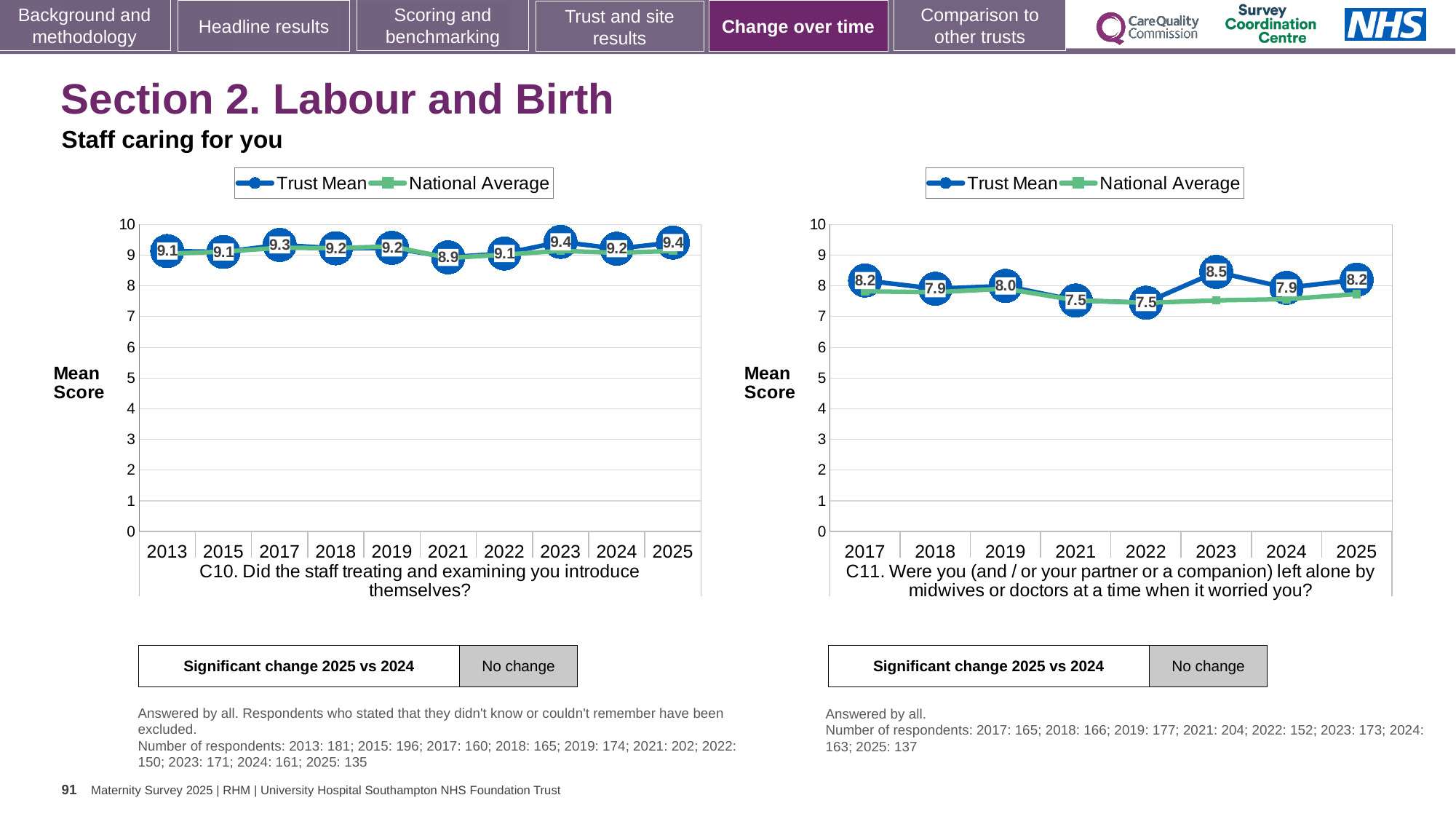
In the C10 chart on the left, what is the Trust Mean score for 2021? 8.9 What kind of chart is the C10 chart on the left? Line chart In the C11 chart on the right, what is the Trust Mean score for 2023? 8.5 In the C10 chart on the left, how many years are shown on the x axis? 10 In the C10 chart on the left, which year has the lowest Trust Mean score? 2021 In the C11 chart on the right, is the Trust Mean score for 2017 or 2021 larger? 2017 In the C10 chart on the left, what is the difference between the Trust Mean scores for 2025 and 2024? 0.2 In the C11 chart on the right, is the National Average value for 2022 greater or less than 8? less In the C11 chart on the right, which year has the highest Trust Mean score? 2023 In the C10 chart on the left, what is the Trust Mean score for 2025? 9.4 How many series does the legend of the C11 chart on the right list? 2 In the C11 chart on the right, what is the difference between the Trust Mean scores for 2023 and 2022? 1.0